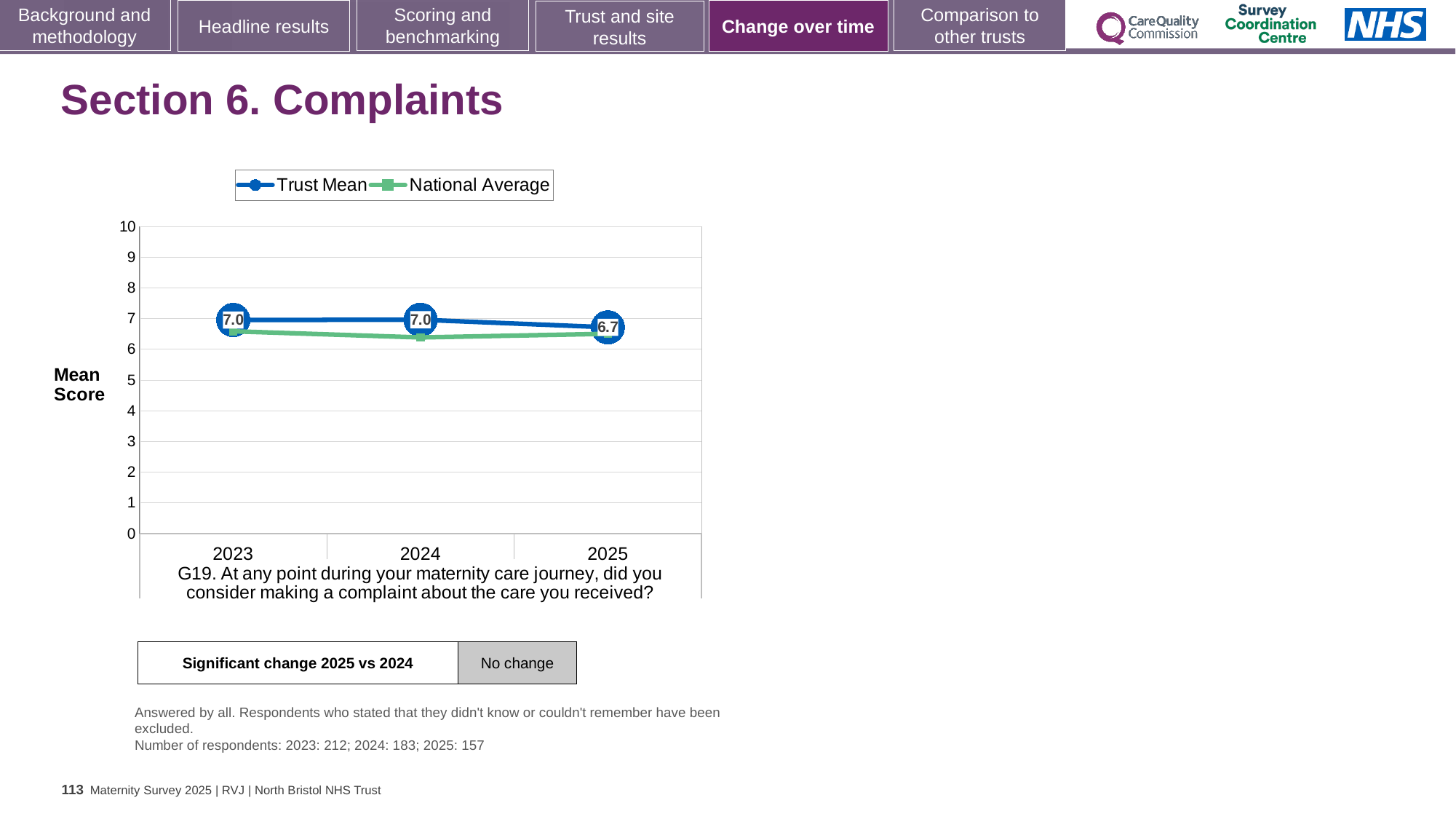
Is the National Average value for 2024 greater or less than 7? less What kind of chart is shown on the slide? Line chart In which year is the Trust Mean score lowest? 2025 How many series does the chart legend list? 2 Is the National Average value for 2023 greater or less than 5? greater What is the difference between the Trust Mean score in 2023 and in 2025? 0.3 What is the Trust Mean score for 2024? 7.0 How many years are plotted on the x axis of the chart? 3 What is the Trust Mean score for 2025? 6.7 In 2024, which is higher: the Trust Mean or the National Average? Trust Mean What is the Trust Mean score for 2023? 7.0 Does the Trust Mean score rise or fall from 2024 to 2025? Fall